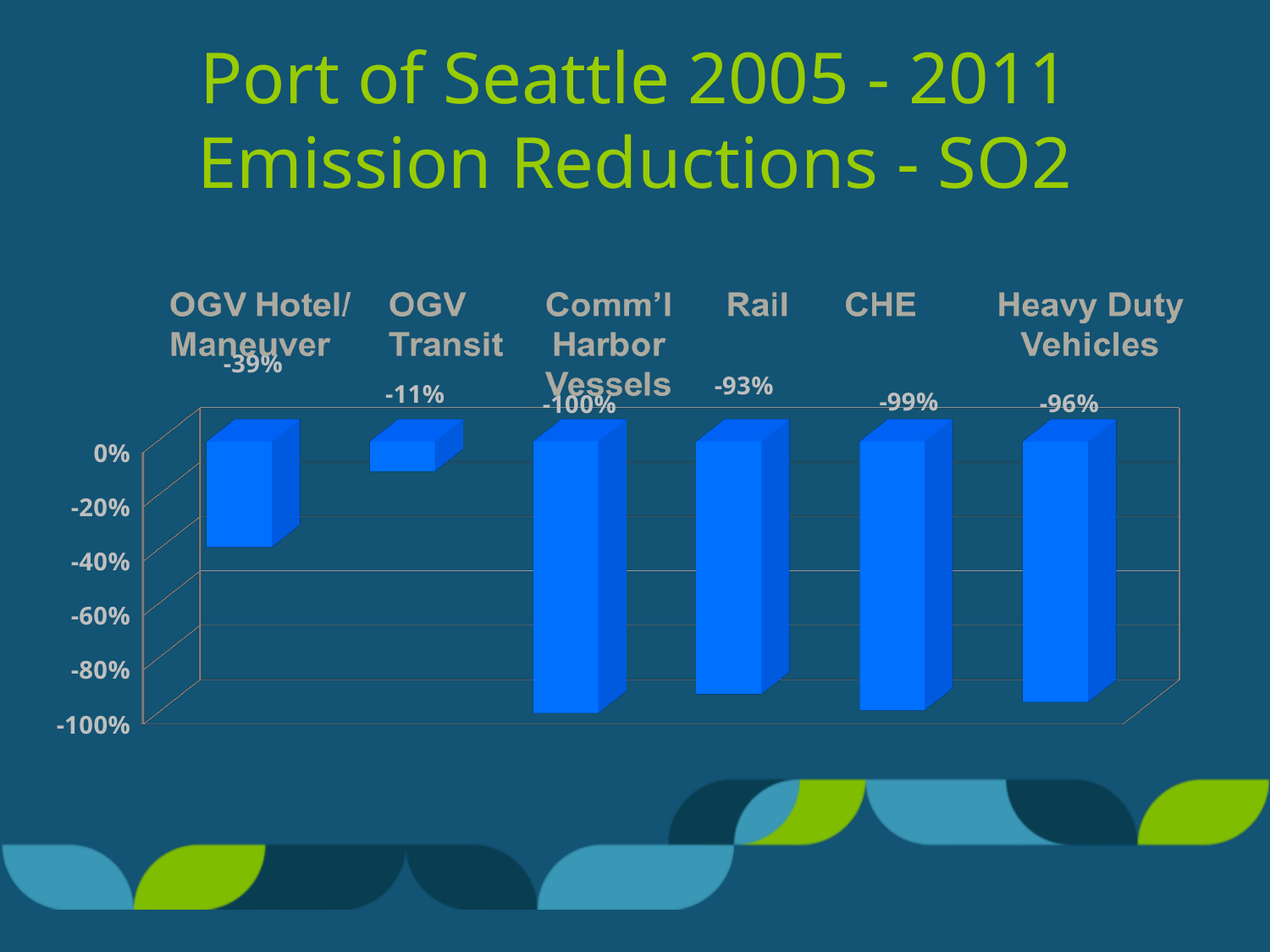
Which category shows the smallest emission reduction (the least negative value)? OGV Transit What is the SO2 emission reduction value shown for Rail? -93% How many categories are shown in the chart? 6 Which category shows the largest emission reduction (the most negative value)? Comm'l Harbor Vessels What value is shown for OGV Transit? -11% Is the value for OGV Hotel/Maneuver greater or less than -20%? less What is the difference in percentage points between the values for CHE and Rail? 6 percentage points What value is shown for CHE? -99% What value is shown for Heavy Duty Vehicles? -96% Which category has a larger reduction, Rail or Heavy Duty Vehicles? Heavy Duty Vehicles What kind of chart is shown on the slide? Bar chart What is the difference in percentage points between the values for OGV Hotel/Maneuver and OGV Transit? 28 percentage points